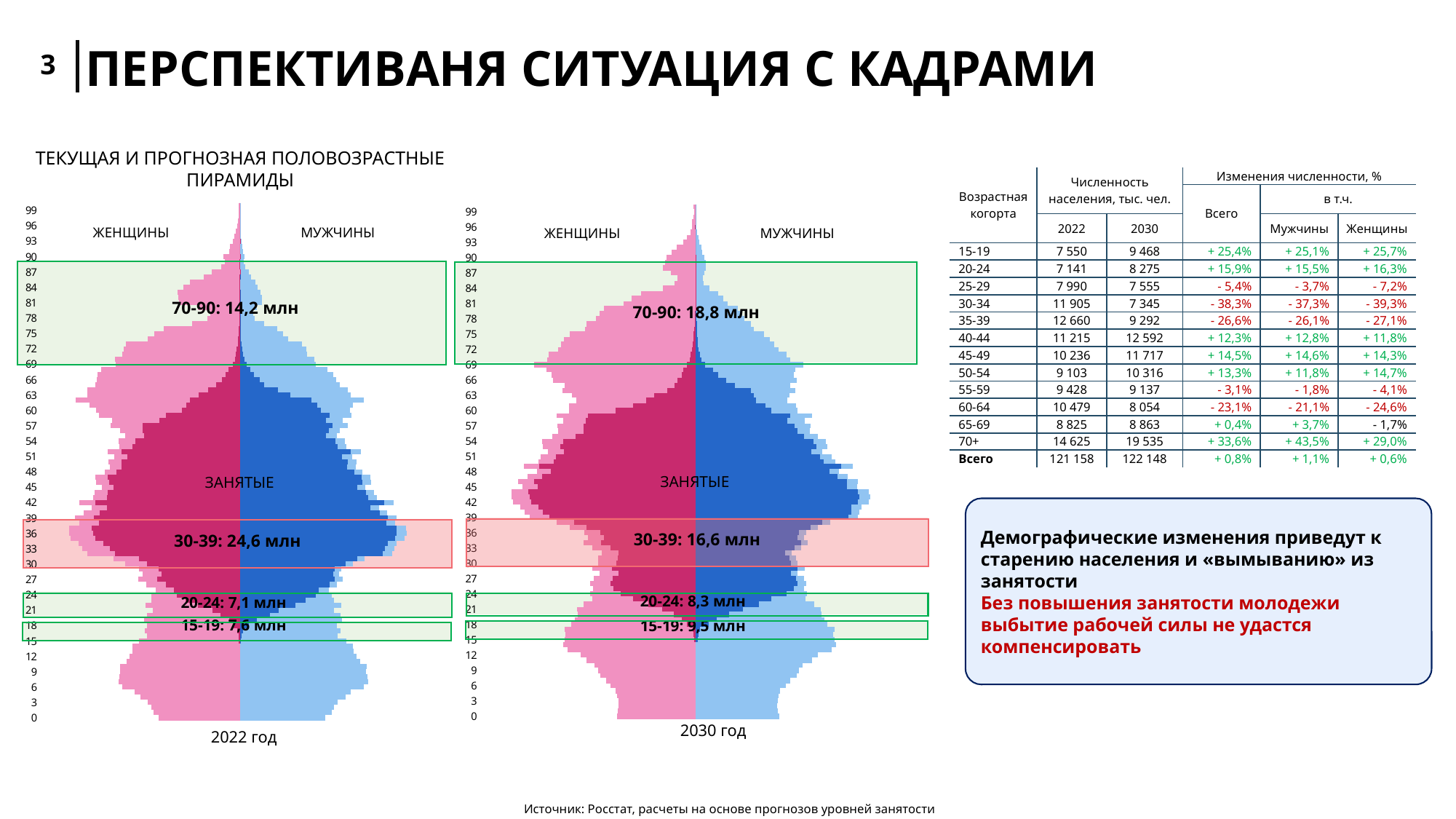
On the 2022 pyramid (left chart), what is the annotated value for the 70-90 age group? 14,2 млн On the 2030 pyramid (right chart), what is the annotated value for the 30-39 age group? 16,6 млн On the 2030 pyramid (right chart), what is the annotated value for the 20-24 age group? 8,3 млн By how much does the annotated 30-39 value on the 2022 pyramid exceed the 30-39 value on the 2030 pyramid? 8,0 млн On the 2030 pyramid (right chart), what is the annotated value for the 70-90 age group? 18,8 млн On the 2022 pyramid (left chart), what is the annotated value for the 30-39 age group? 24,6 млн Which pyramid shows the larger annotated value for the 70-90 age group, 2022 or 2030? 2030 What is the title above the two population pyramids? ТЕКУЩАЯ И ПРОГНОЗНАЯ ПОЛОВОЗРАСТНЫЕ ПИРАМИДЫ What kind of chart are the two population pyramids on the slide? Bar chart (population pyramid) By how much does the annotated 70-90 value on the 2030 pyramid exceed the 70-90 value on the 2022 pyramid? 4,6 млн On the 2030 pyramid (right chart), what is the annotated value for the 15-19 age group? 9,5 млн Which pyramid shows the larger annotated value for the 30-39 age group, 2022 or 2030? 2022